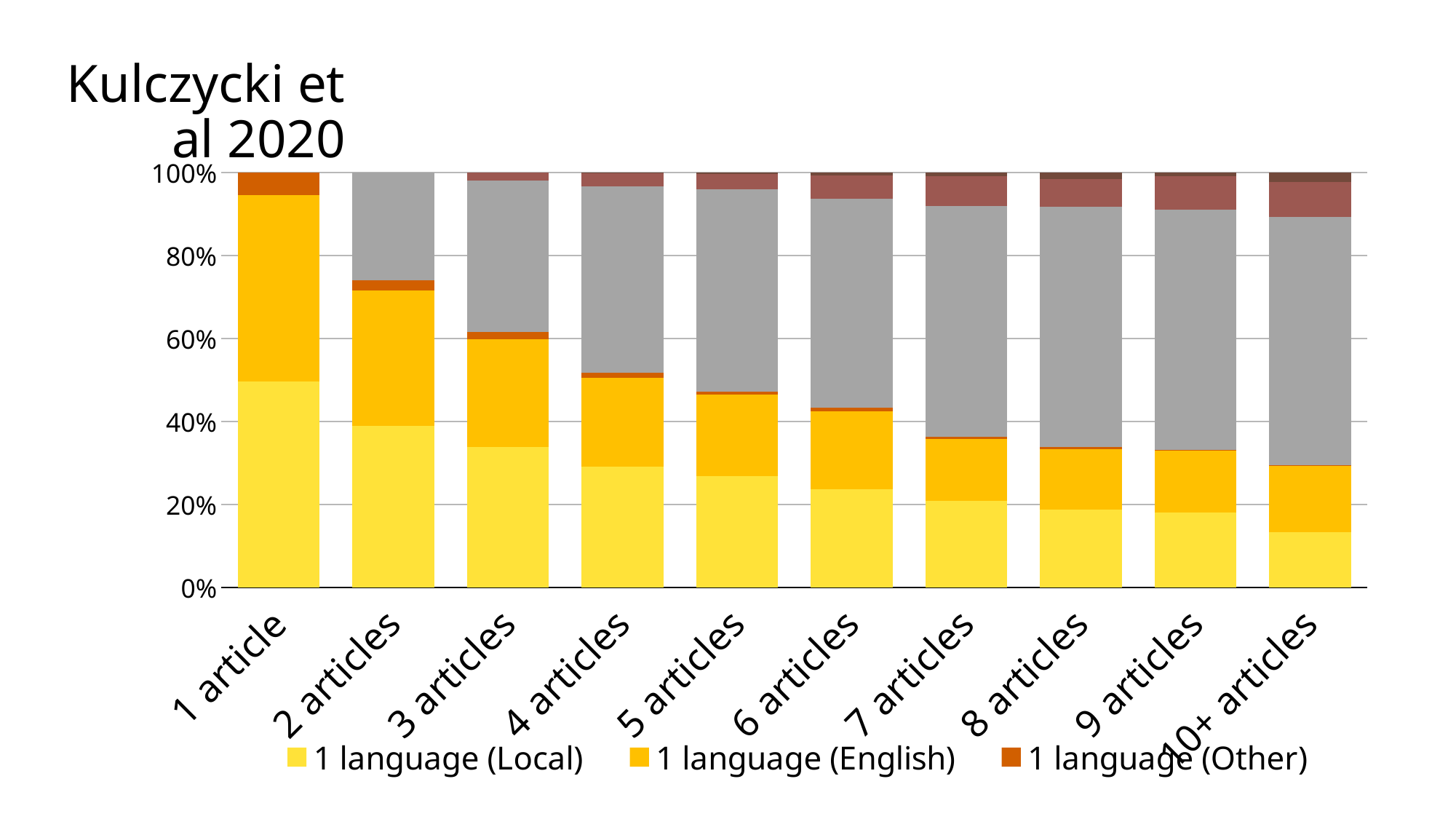
Which category has the largest '1 language (Local)' share? 1 article Is the '1 language (Local)' share for 3 articles greater or less than 40%? less Does the '1 language (Local)' share rise or fall as the number of articles increases along the x axis? fall Is the '1 language (Local)' share for 10+ articles greater or less than 20%? less Which has a larger '1 language (Local)' share, 1 article or 10+ articles? 1 article Is the '1 language (Local)' share for 1 article greater or less than 40%? greater What does each stacked bar total? 100% How many series does the legend list? 3 What kind of chart is shown on the slide? Stacked bar chart Which category has the smallest '1 language (Local)' share? 10+ articles What is the title of the chart? Kulczycki et al 2020 How many article-count categories are shown along the x axis? 10